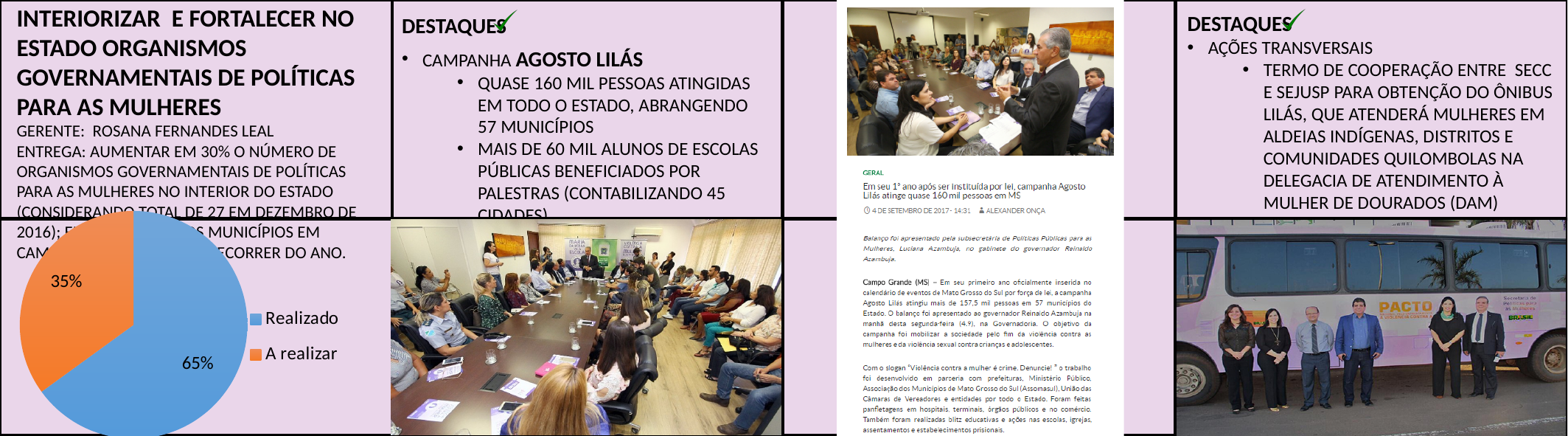
What colour is the "Realizado" slice in the pie chart? blue Which slice of the pie chart is the smallest? A realizar What is the value for "A realizar" in the pie chart? 35% What colour is the "A realizar" slice in the pie chart? orange Which is larger in the pie chart, "Realizado" or "A realizar"? Realizado What share of the pie does the "Realizado" slice represent? 65% What kind of chart is shown on the slide? pie chart What is the value for "Realizado" in the pie chart? 65% What is the difference between the "Realizado" and "A realizar" slices? 30% How many entries does the pie chart legend list? 2 Which slice of the pie chart is the largest? Realizado How many slices does the pie chart have? 2